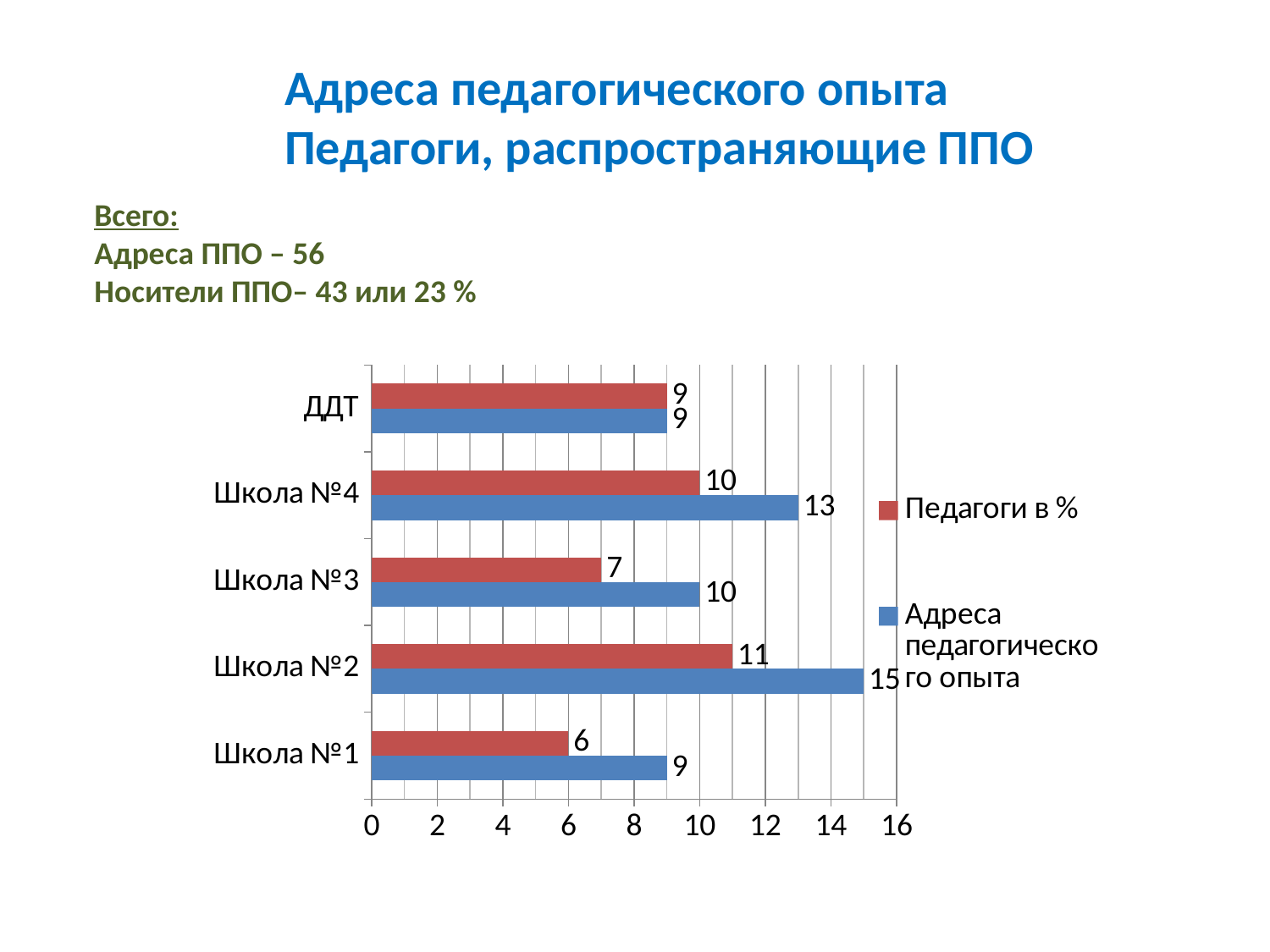
What is the value of 'Педагоги в %' for ДДТ? 9 What is the value of 'Педагоги в %' for Школа №3? 7 Which category has the lowest value for 'Педагоги в %'? Школа №1 Which category has the highest value for 'Адреса педагогического опыта'? Школа №2 How many categories are shown on the chart? 5 What kind of chart is shown on the slide? bar chart What is the difference between 'Адреса педагогического опыта' and 'Педагоги в %' for Школа №2? 4 What is the difference between 'Адреса педагогического опыта' for Школа №2 and Школа №1? 6 What colour are the bars for the series 'Педагоги в %'? red What is the value of 'Адреса педагогического опыта' for Школа №2? 15 Which is larger for Школа №4: 'Адреса педагогического опыта' or 'Педагоги в %'? Адреса педагогического опыта How many series does the legend list? 2